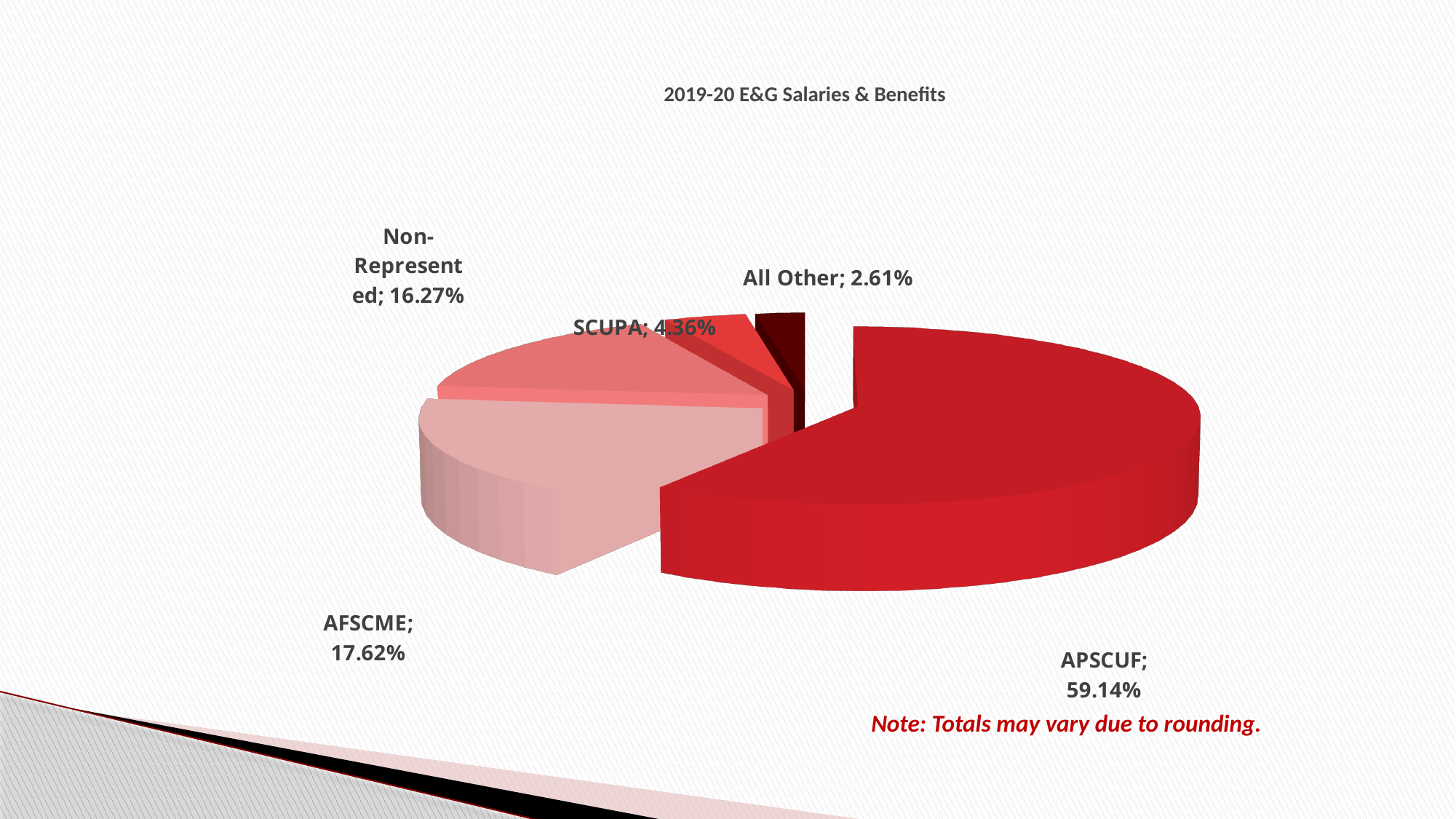
What share of the pie does APSCUF represent? 59.14% What is the difference between the AFSCME and Non-Represented shares? 1.35% What is the value shown for SCUPA? 4.36% What is the value shown for All Other? 2.61% What is the value shown for AFSCME? 17.62% Which category has the smallest slice of the pie? All Other What is the value shown for Non-Represented? 16.27% How many categories are shown in the pie chart? 5 Which is larger, the SCUPA share or the All Other share? SCUPA What is the title of the chart? 2019-20 E&G Salaries & Benefits Which category has the largest slice of the pie? APSCUF What kind of chart is shown on the slide? Pie chart